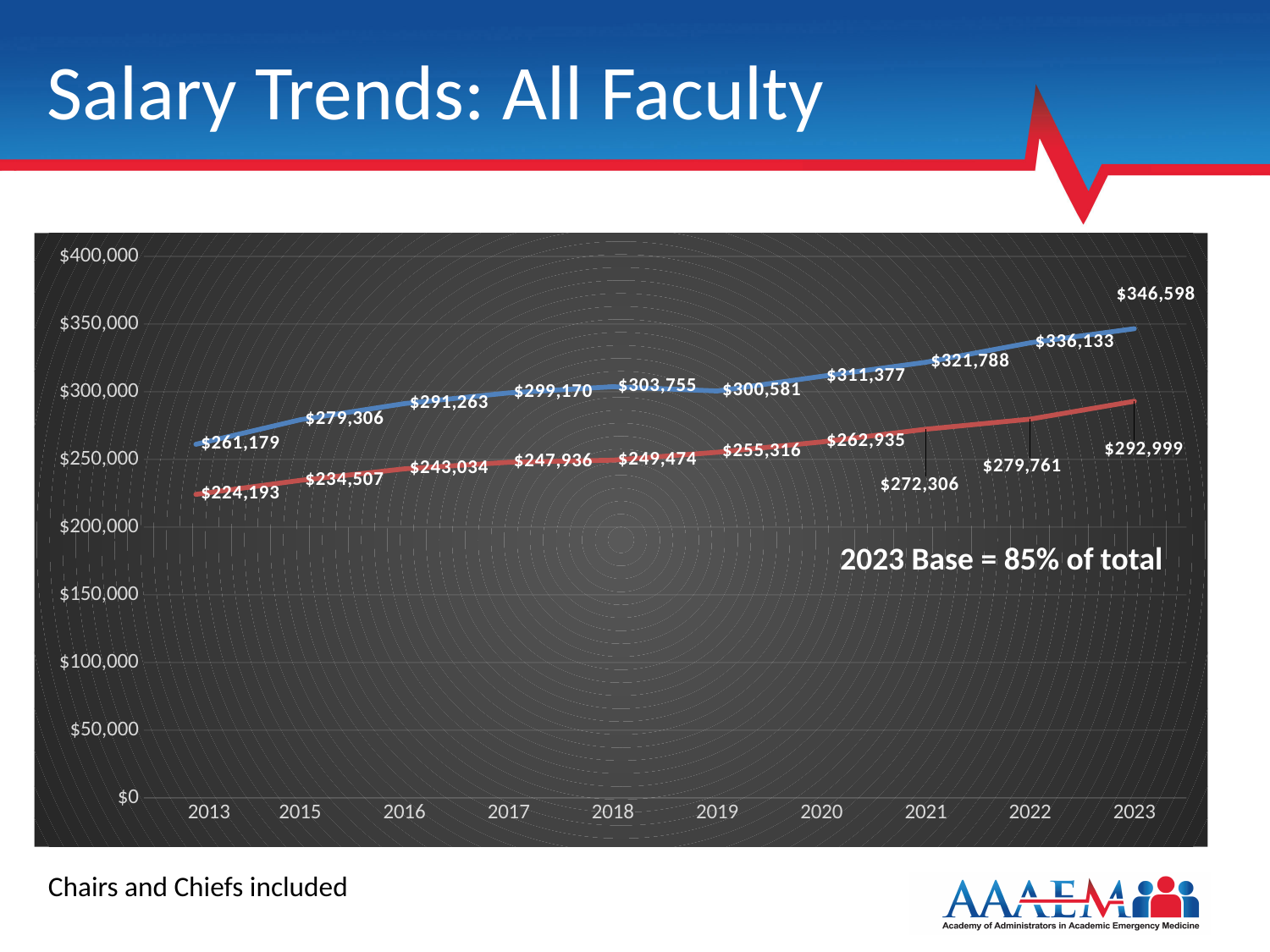
In which year does the blue line reach its highest value? 2023 What is the difference between the blue line and the red line in 2023? $53,599 In which year does the red line have its lowest value? 2013 What is the value of the blue line in 2019? $300,581 What is the value of the red line in 2021? $272,306 What is the value of the blue line in 2023? $346,598 By how much did the blue line increase from 2013 to 2023? $85,419 How many years are shown on the x axis? 10 What is the value of the red line in 2013? $224,193 Does the red line generally rise or fall from 2013 to 2023? Rise Which is larger, the blue line's value in 2018 or its value in 2019? 2018 What type of chart is shown on the slide? Line chart